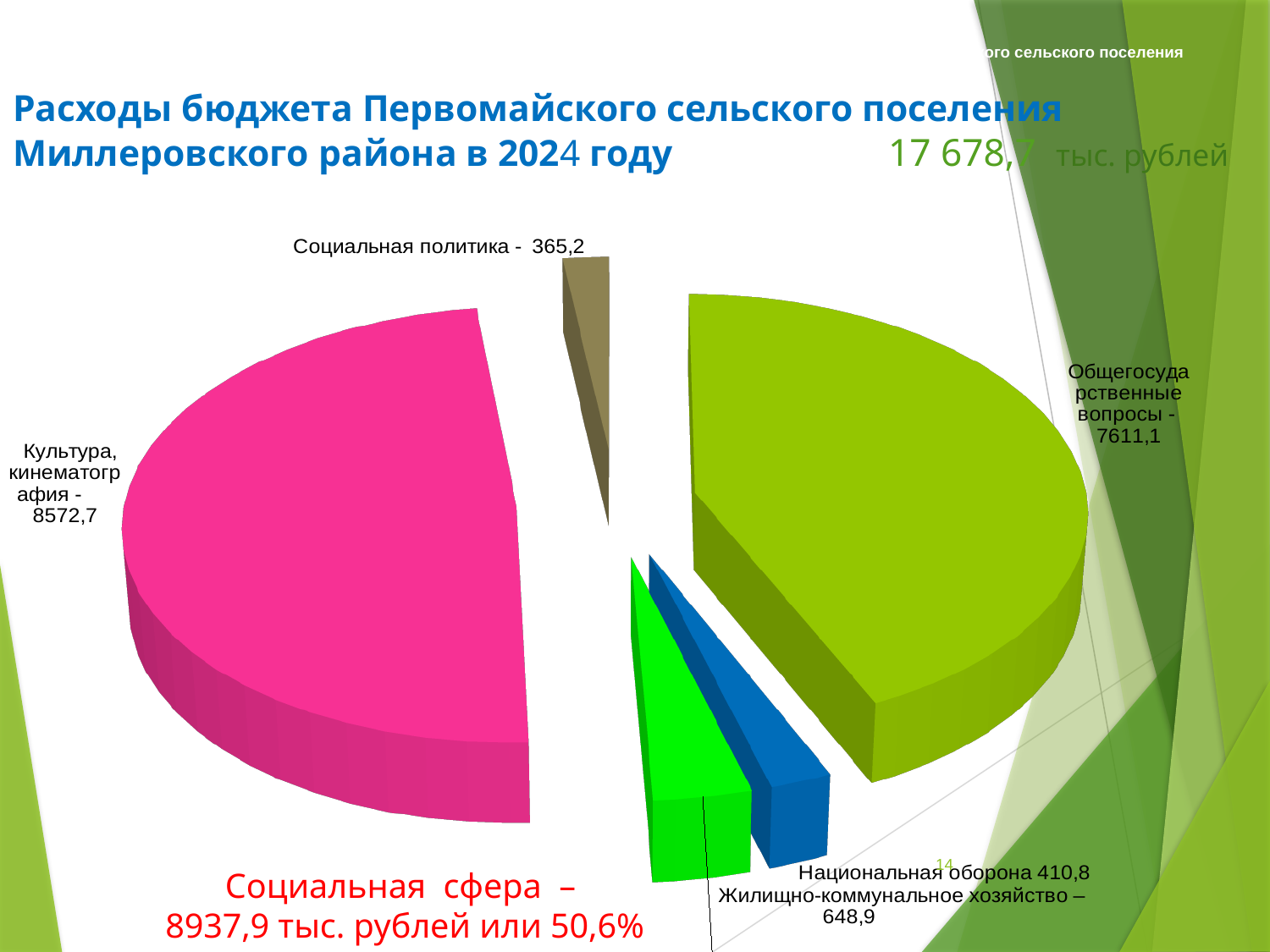
What kind of chart is shown on the slide? Pie chart What is the value for Жилищно-коммунальное хозяйство? 648,9 How many categories (slices) does the pie chart show? 5 What is the value for Социальная политика? 365,2 Which category has the smallest value? Социальная политика What colour is the slice for Культура, кинематография? Pink Which is larger: Жилищно-коммунальное хозяйство or Национальная оборона? Жилищно-коммунальное хозяйство What is the difference between Культура, кинематография and Общегосударственные вопросы? 961,6 What is the value for Культура, кинематография? 8572,7 What is the value for Национальная оборона? 410,8 What is the value for Общегосударственные вопросы? 7611,1 Which category has the largest value? Культура, кинематография